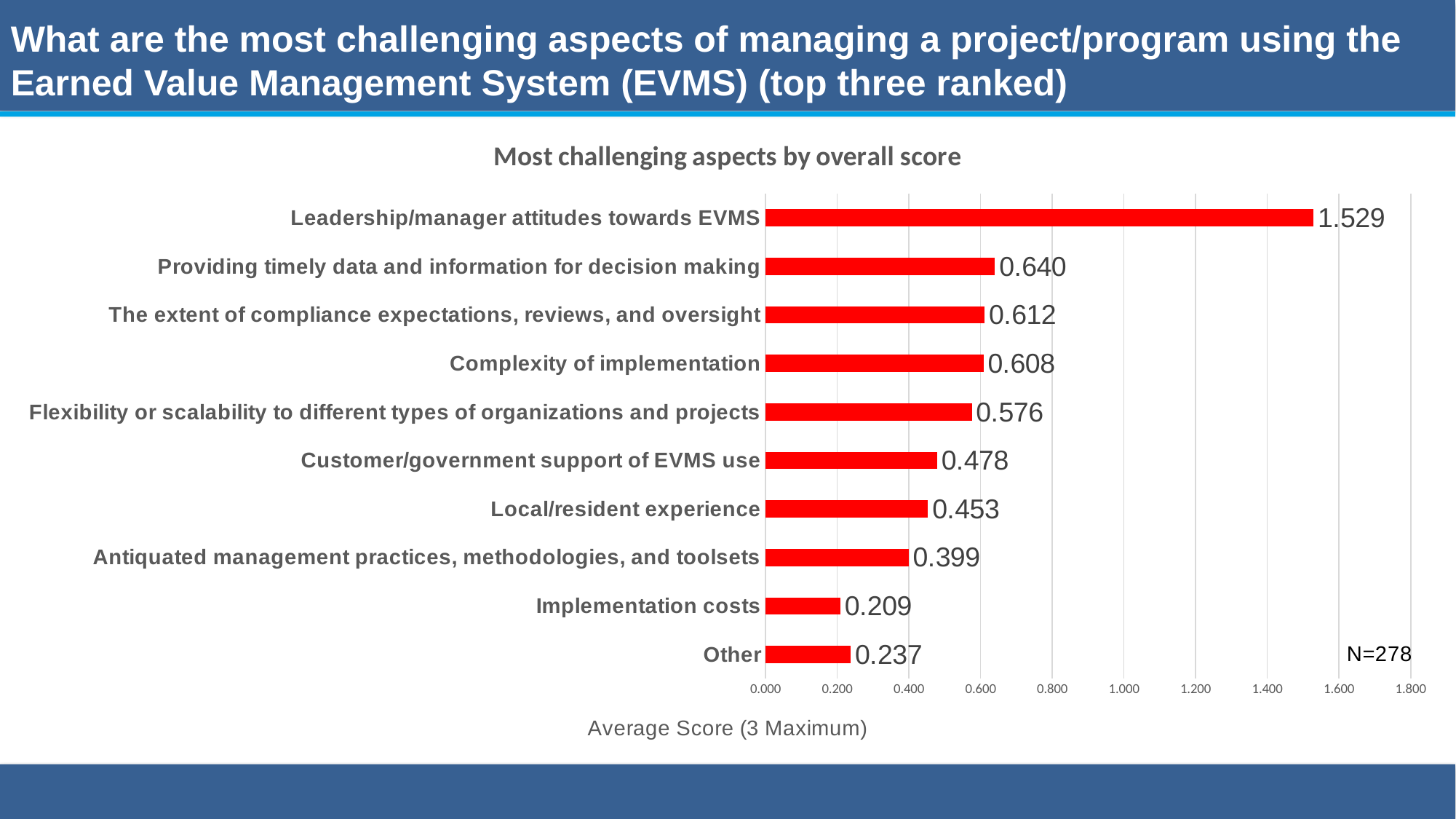
What is the average score for Complexity of implementation? 0.608 Which has a higher score: Customer/government support of EVMS use or Local/resident experience? Customer/government support of EVMS use What is the title of the chart? Most challenging aspects by overall score What type of chart is shown on the slide? Bar chart What is the average score for Implementation costs? 0.209 Which aspect has the highest overall score? Leadership/manager attitudes towards EVMS Is the value for Antiquated management practices, methodologies, and toolsets greater or less than 0.400? less What is the average score for Leadership/manager attitudes towards EVMS? 1.529 What is the difference between the scores for Leadership/manager attitudes towards EVMS and Providing timely data and information for decision making? 0.889 What is the difference between the scores for Other and Implementation costs? 0.028 How many aspects are shown in the chart? 10 Which aspect has the lowest overall score? Implementation costs